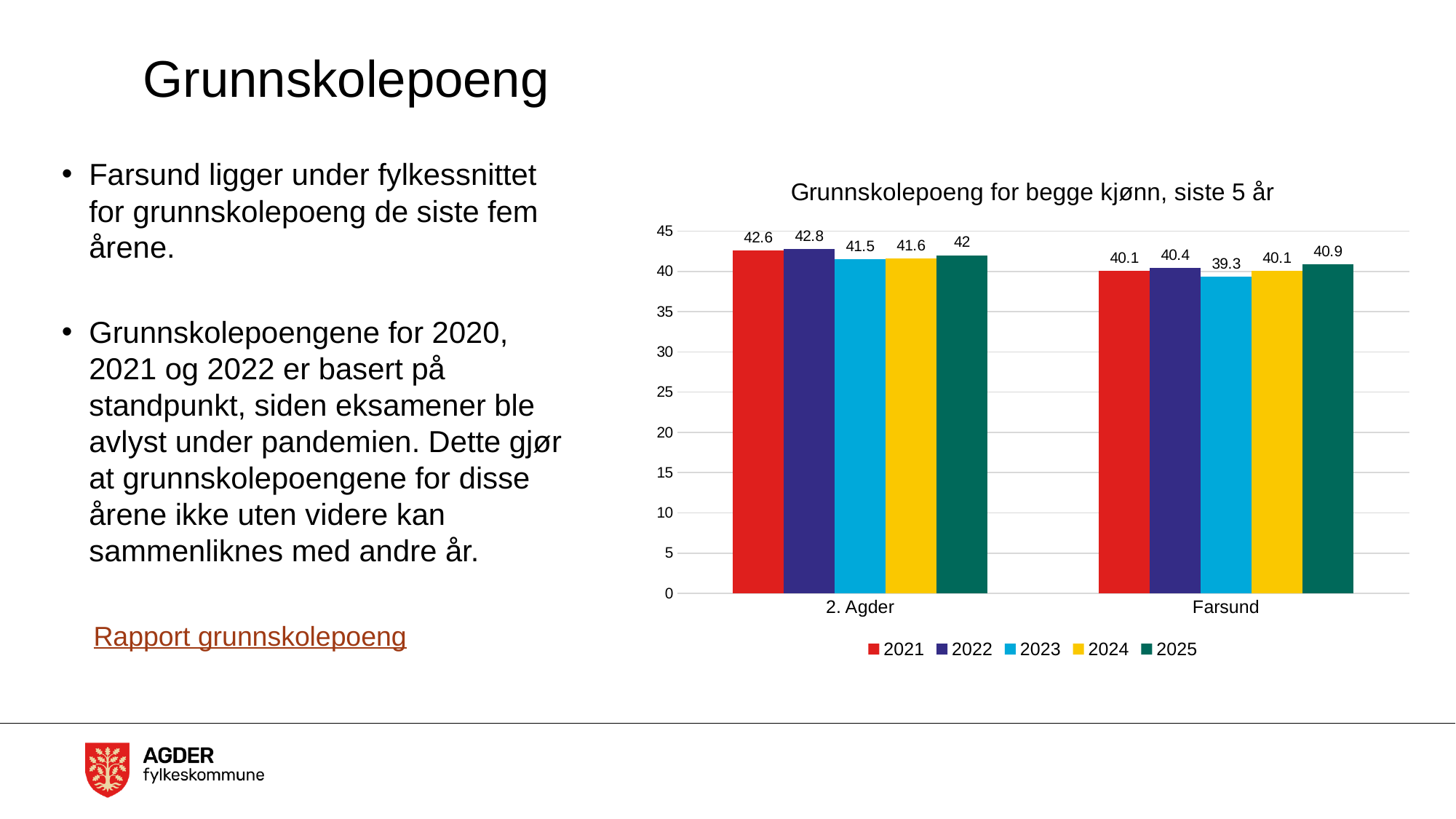
What is the difference between the 2. Agder and Farsund values in 2022? 2.4 What is the value for 2. Agder in 2021? 42.6 What is the value for Farsund in 2023? 39.3 Which year has the highest value for 2. Agder? 2022 Which year has the lowest value for Farsund? 2023 Is the value for Farsund in 2023 greater or less than 40? less What is the value for Farsund in 2025? 40.9 How many categories are shown on the x axis? 2 What kind of chart is shown? bar chart Which is larger, the 2024 value for 2. Agder or the 2024 value for Farsund? 2. Agder What is the title of the chart? Grunnskolepoeng for begge kjønn, siste 5 år How many series does the legend list? 5